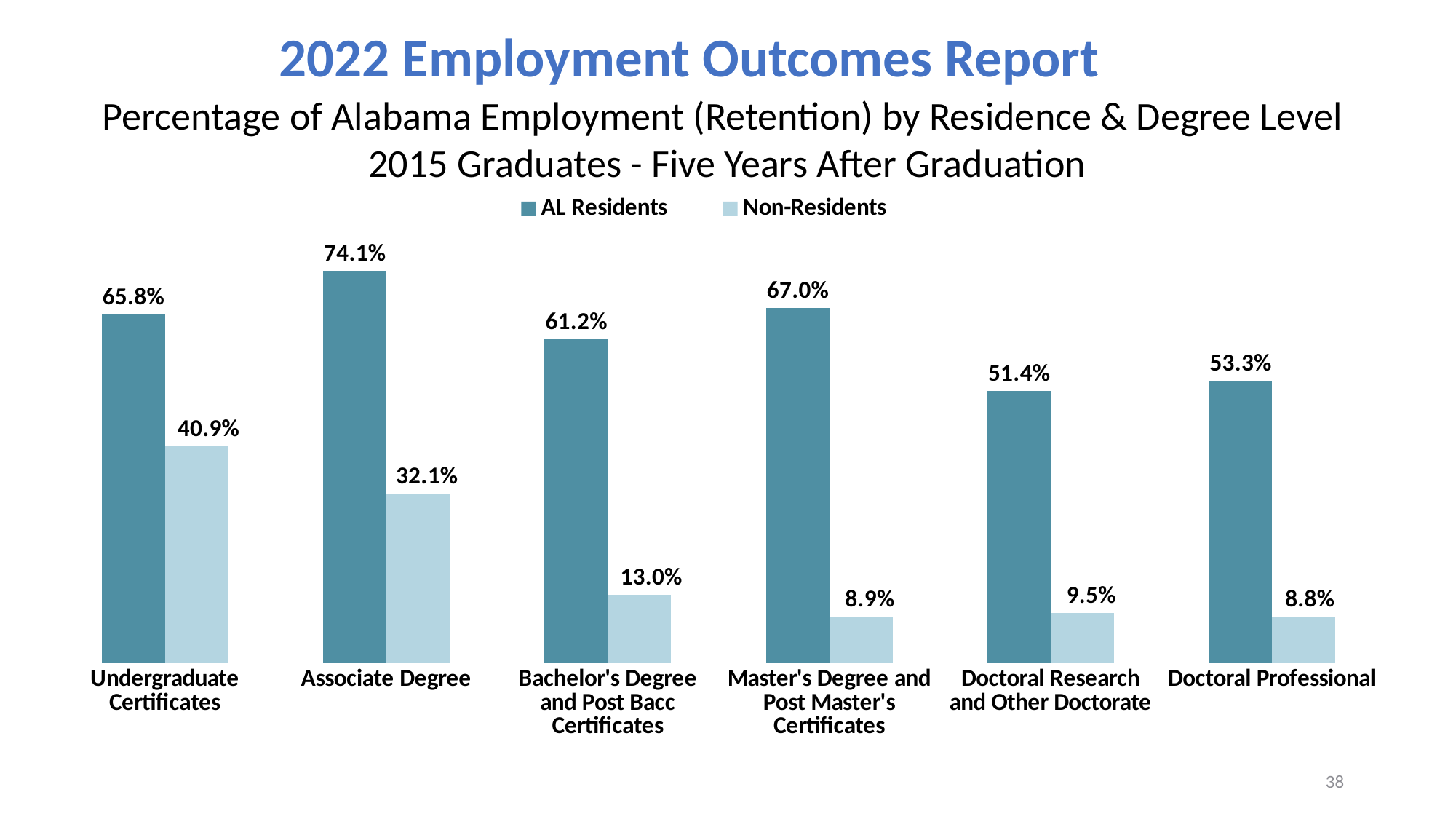
How many series does the legend list? 2 What is the difference between the AL Residents and Non-Residents values for Undergraduate Certificates? 24.9% Which is larger: the AL Residents value for Master's Degree and Post Master's Certificates or for Bachelor's Degree and Post Bacc Certificates? Master's Degree and Post Master's Certificates What is the AL Residents value for Doctoral Professional? 53.3% What is the Non-Residents value for Bachelor's Degree and Post Bacc Certificates? 13.0% Which series is shown in the darker blue colour? AL Residents What is the AL Residents value for Associate Degree? 74.1% Which degree level has the highest AL Residents value? Associate Degree What is the Non-Residents value for Doctoral Research and Other Doctorate? 9.5% What kind of chart is shown on the slide? Bar chart Which degree level has the lowest Non-Residents value? Doctoral Professional How many degree level categories are shown on the chart? 6